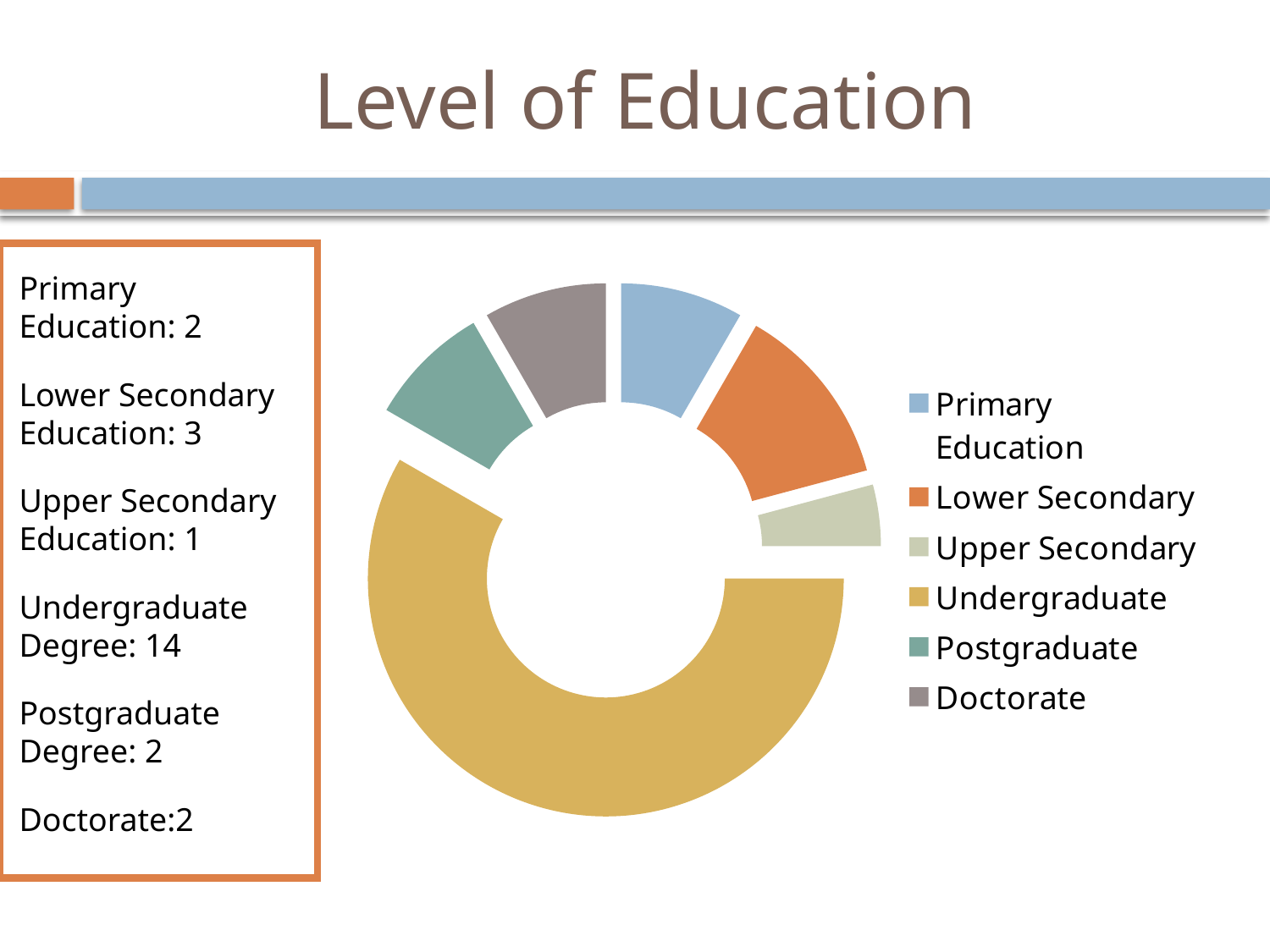
How many categories does the chart show? 6 Which is larger, the Lower Secondary slice or the Primary Education slice? Lower Secondary How many entries does the legend list? 6 What is the difference between the Undergraduate value and the Lower Secondary value? 11 Which level of education has the smallest slice? Upper Secondary What kind of chart is shown on the slide? doughnut chart What is the value for Undergraduate Degree? 14 What is the value for Upper Secondary Education? 1 What is the total of all the values shown in the chart? 24 What is the title of the slide? Level of Education Which level of education has the largest slice? Undergraduate What is the value for Lower Secondary Education? 3